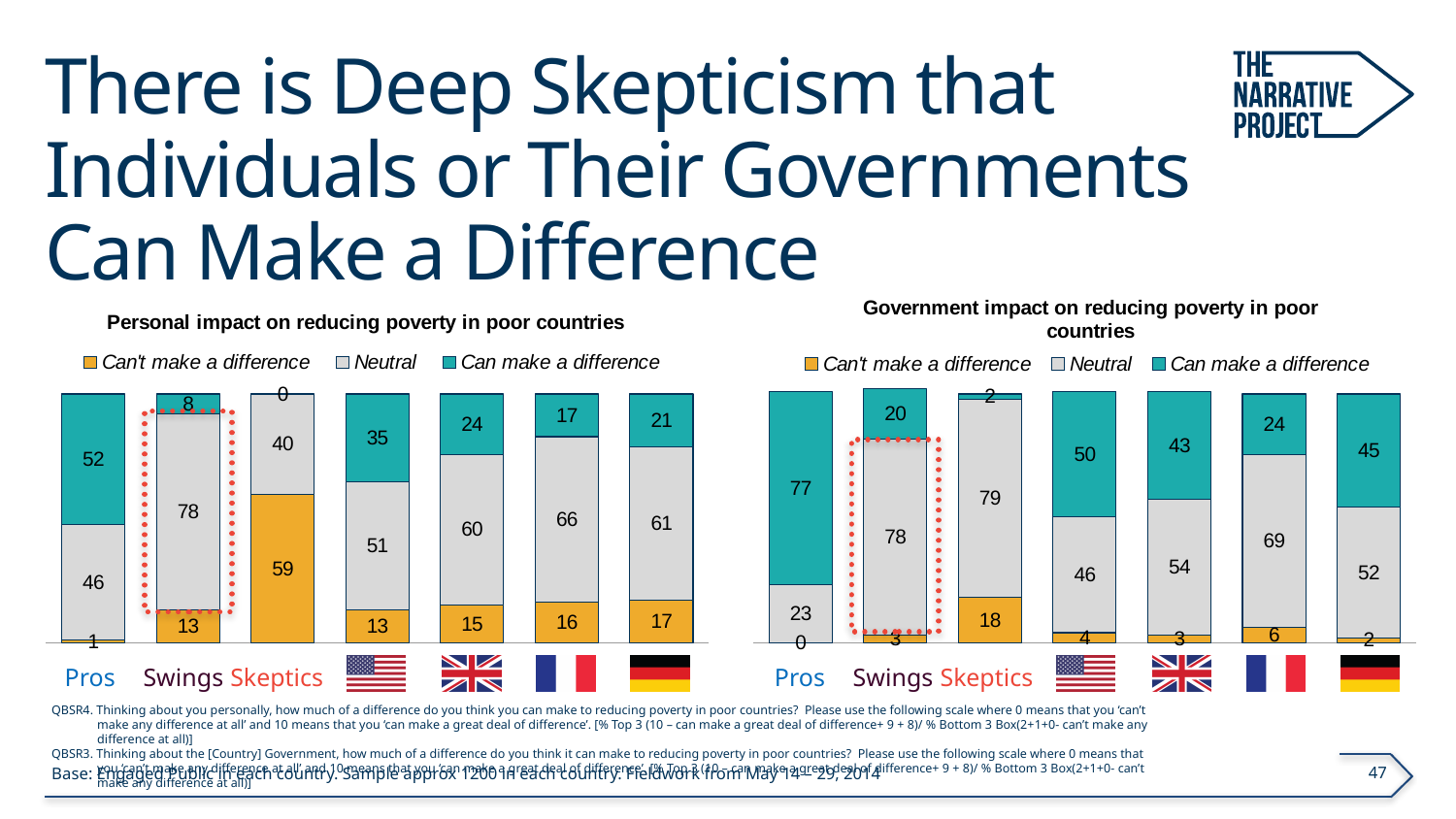
In the 'Personal impact on reducing poverty in poor countries' chart, what is the total of the stacked bar for Swings? 99 In the 'Government impact on reducing poverty in poor countries' chart, what is the Neutral value for Skeptics? 79 In the 'Personal impact on reducing poverty in poor countries' chart, what is the 'Can make a difference' value for Pros? 52 In the 'Government impact on reducing poverty in poor countries' chart, what is the 'Can make a difference' value for Pros? 77 In the 'Personal impact on reducing poverty in poor countries' chart, what is the difference between the 'Can make a difference' values for Pros and Skeptics? 52 In the 'Personal impact on reducing poverty in poor countries' chart, which category has the highest 'Can't make a difference' value? Skeptics In the 'Government impact on reducing poverty in poor countries' chart, which category has the lowest 'Can make a difference' value? Skeptics In the 'Personal impact on reducing poverty in poor countries' chart, what is the 'Can't make a difference' value for Skeptics? 59 What kind of chart is the 'Personal impact on reducing poverty in poor countries' chart? Stacked bar chart In the 'Government impact on reducing poverty in poor countries' chart, what is the difference between the Neutral and 'Can make a difference' values for Swings? 58 In the 'Personal impact on reducing poverty in poor countries' chart, which has the larger Neutral value, Swings or Skeptics? Swings How many series does the legend of the 'Government impact on reducing poverty in poor countries' chart list? 3